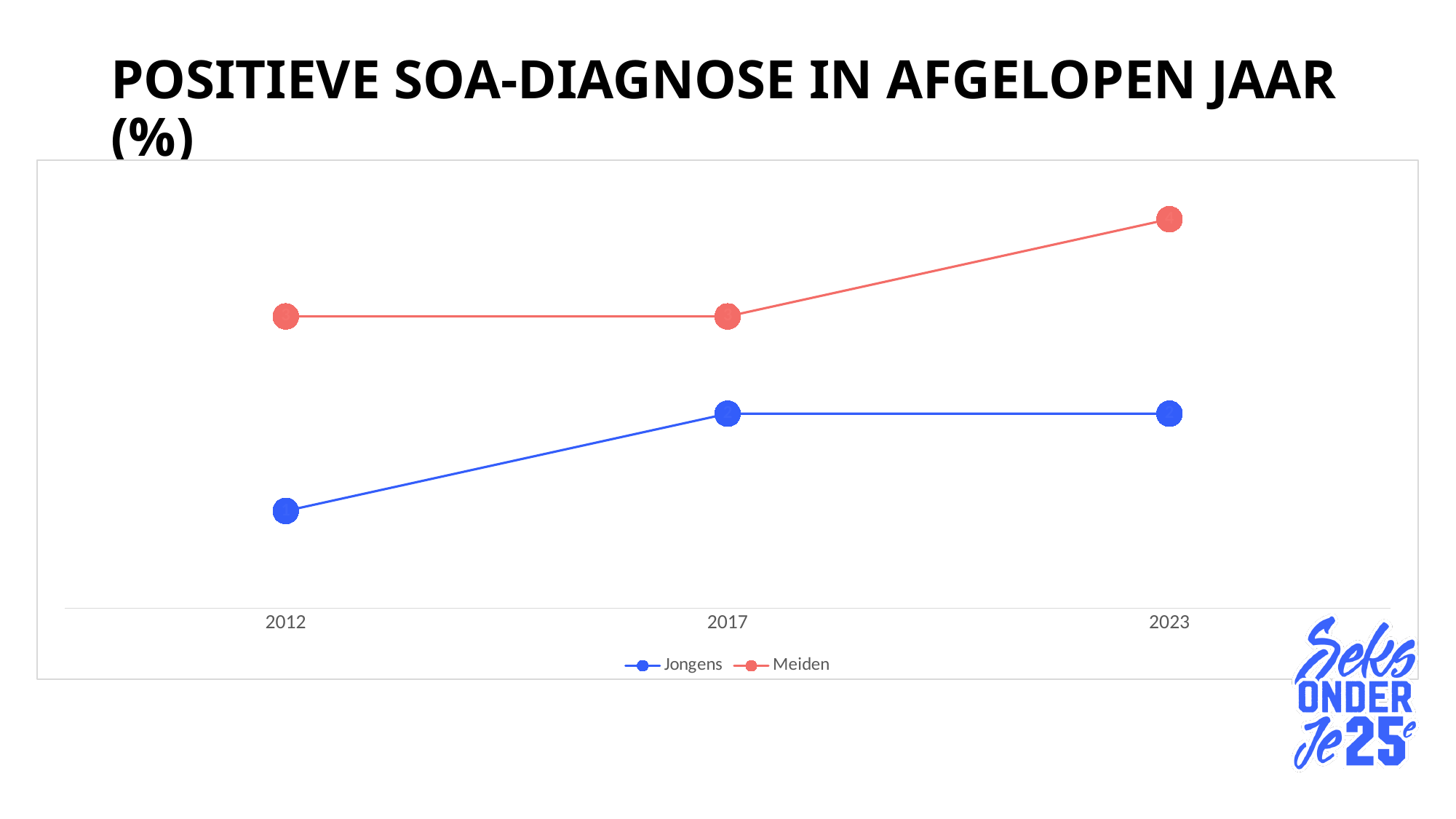
Does the value for Jongens rise or fall between 2012 and 2017? rise In which year is the value for Meiden highest? 2023 How many series does the legend list? 2 How many years are shown on the x axis? 3 What kind of chart is shown on the slide? line chart In which year is the value for Jongens lowest? 2012 Which years are shown on the x axis? 2012, 2017, 2023 Which colour is used for the Jongens series? blue In 2012, which series has the higher value, Jongens or Meiden? Meiden Does the value for Meiden rise or fall between 2017 and 2023? rise What is the title of the chart? POSITIEVE SOA-DIAGNOSE IN AFGELOPEN JAAR (%) In 2023, which series has the higher value, Jongens or Meiden? Meiden